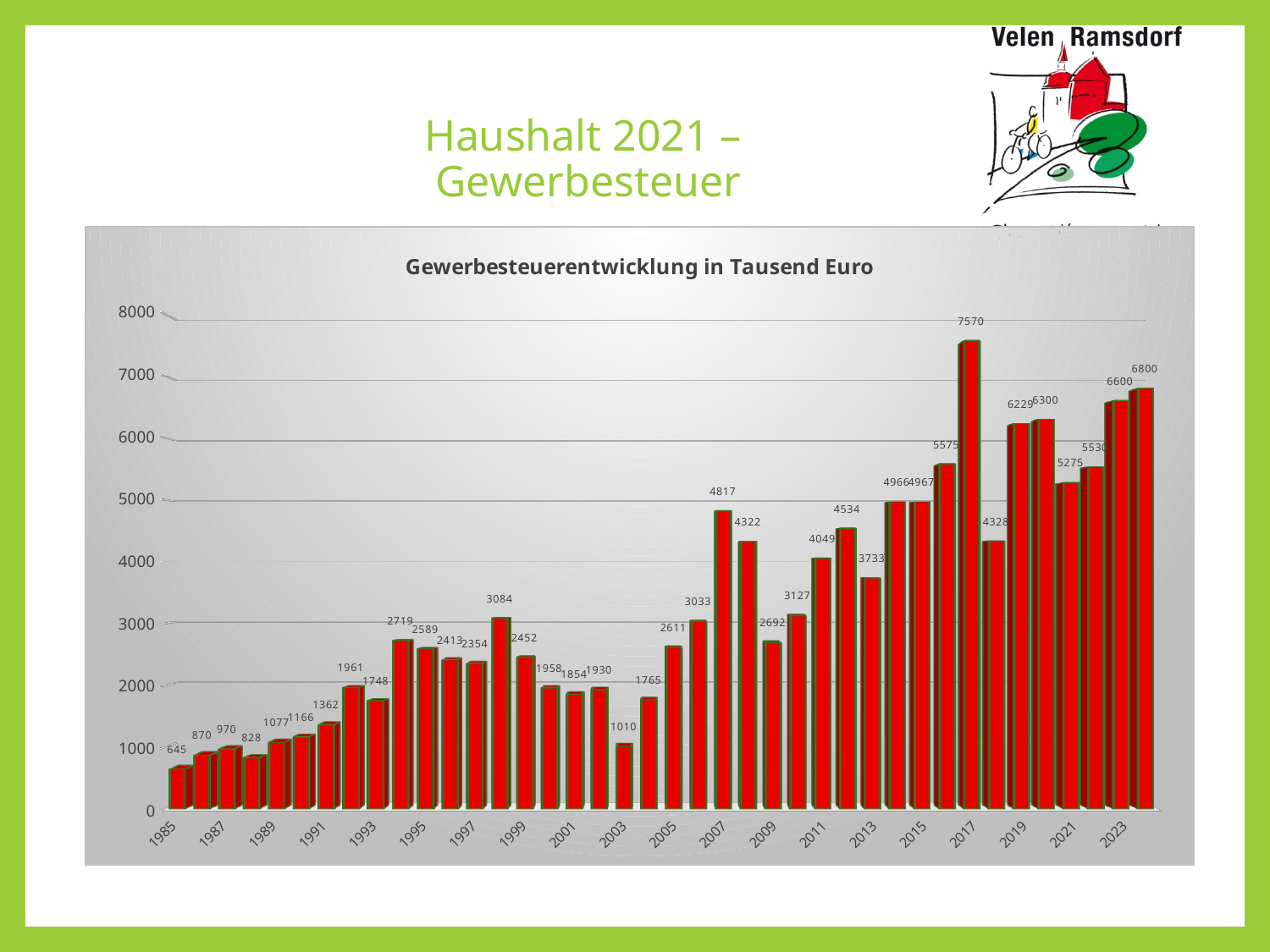
What is the value for 2003 in the Gewerbesteuerentwicklung chart? 1010 Which year has the lowest value in the Gewerbesteuerentwicklung chart? 1985 What kind of chart is shown on the slide? bar chart What is the title of the chart on the slide? Gewerbesteuerentwicklung in Tausend Euro What is the value for 1985 in the Gewerbesteuerentwicklung chart? 645 What is the value for 2007 in the Gewerbesteuerentwicklung chart? 4817 Do the values in the Gewerbesteuerentwicklung chart rise or fall from 1985 to 1991? rise Which year has the larger value in the Gewerbesteuerentwicklung chart, 2019 or 2021? 2019 Which year has the highest value in the Gewerbesteuerentwicklung chart? 2017 Is the value for 2013 in the Gewerbesteuerentwicklung chart greater or less than 3000? greater What is the value for 2017 in the Gewerbesteuerentwicklung chart? 7570 What is the difference between the values for 2017 and 2007 in the Gewerbesteuerentwicklung chart? 2753